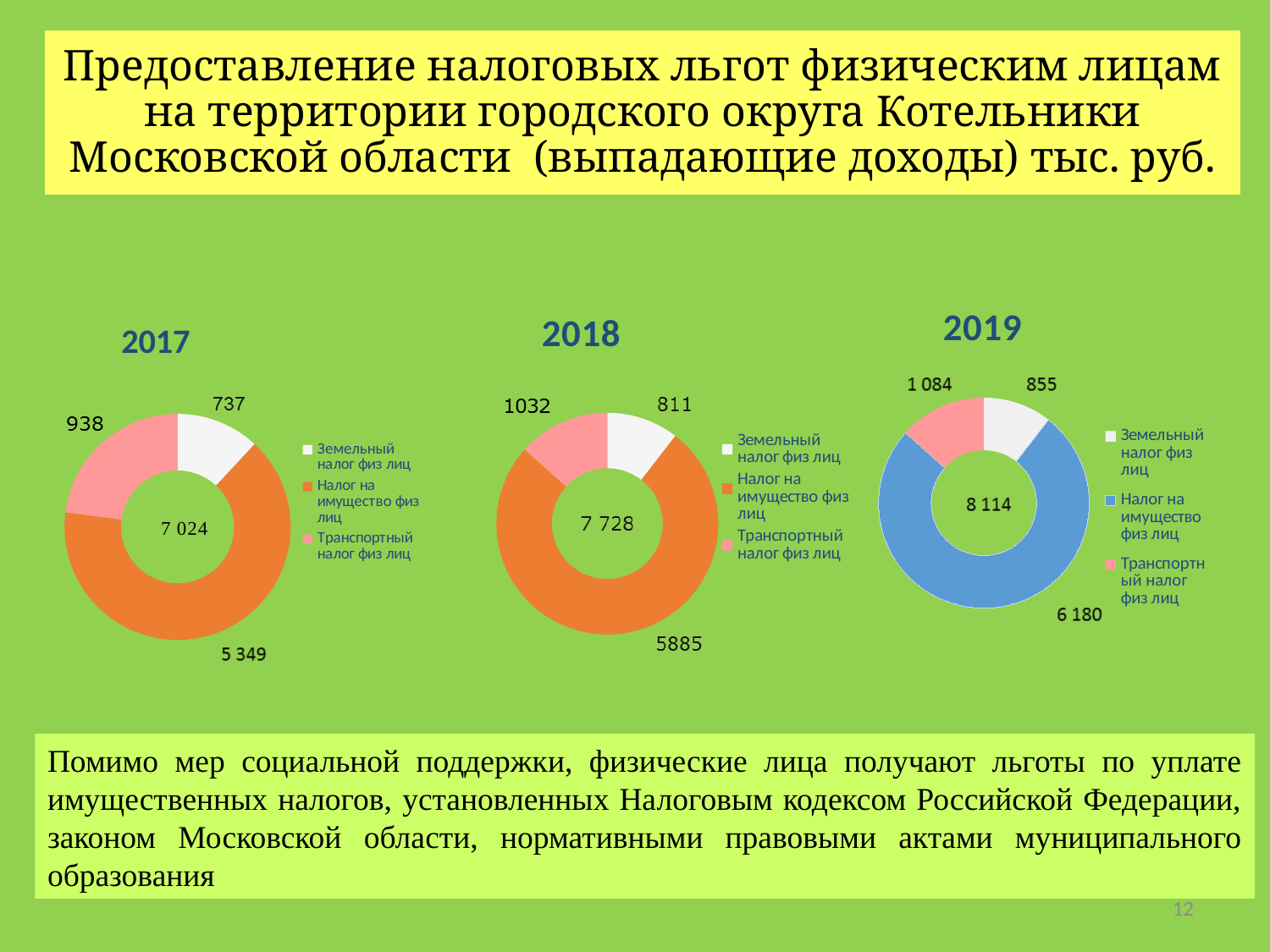
In the 2019 chart, what is the value for Земельный налог физ лиц? 855 In the 2017 chart, what is the difference between Транспортный налог физ лиц and Земельный налог физ лиц? 201 In the 2017 chart, what is the value for Налог на имущество физ лиц? 5 349 In the 2017 chart, which category has the smallest value? Земельный налог физ лиц In the 2018 chart, which category has the largest value? Налог на имущество физ лиц In the 2018 chart, which is larger: Земельный налог физ лиц or Транспортный налог физ лиц? Транспортный налог физ лиц In the 2019 chart, what is the value for Налог на имущество физ лиц? 6 180 How many categories does the 2019 chart show? 3 In the 2018 chart, what is the value for Транспортный налог физ лиц? 1032 What type of chart is used for 2017? Doughnut chart What is the total shown in the centre of the 2018 chart? 7 728 In the 2019 chart, what is the difference between Транспортный налог физ лиц and Земельный налог физ лиц? 229